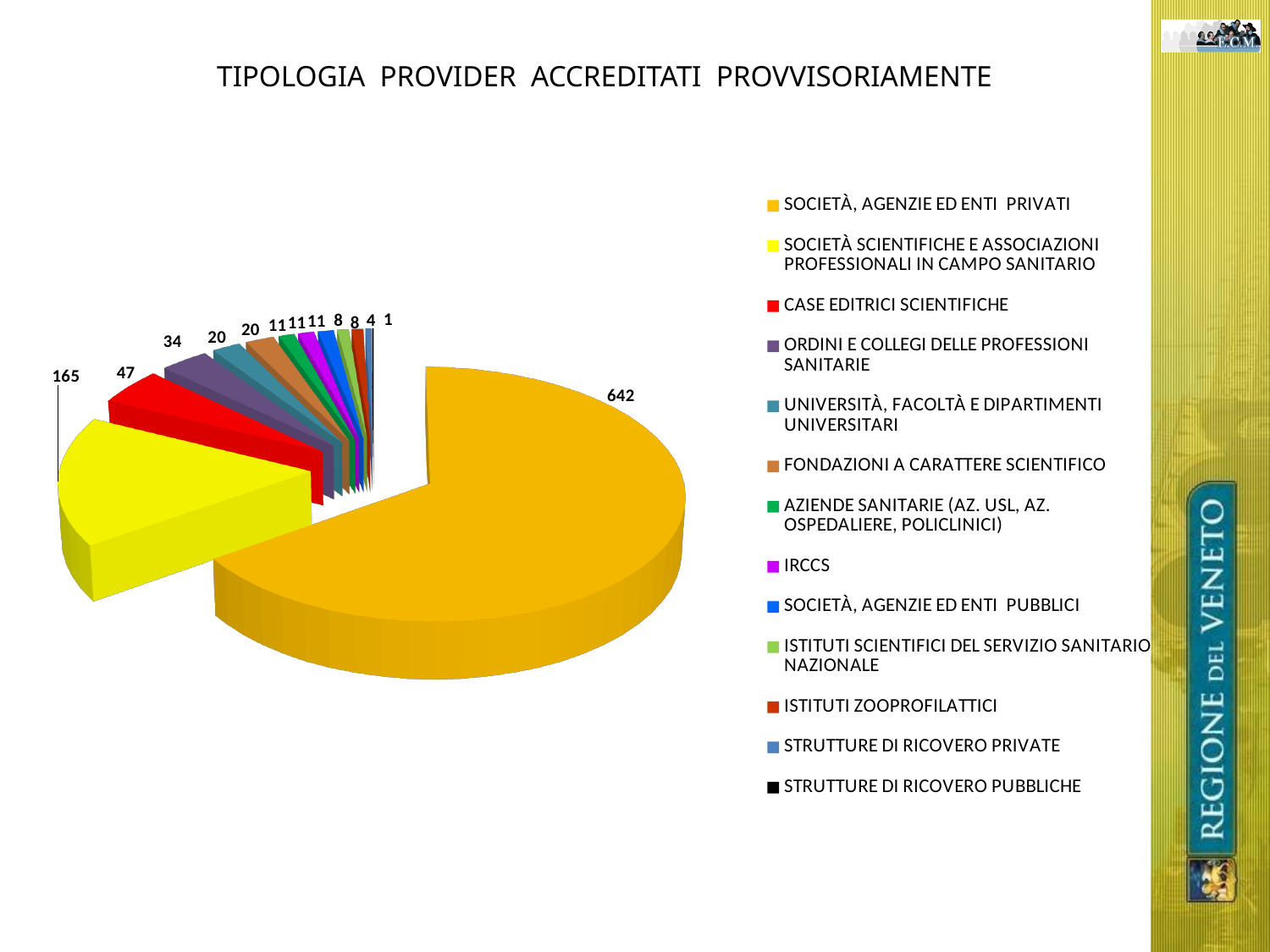
Which category has the largest slice of the pie? SOCIETÀ, AGENZIE ED ENTI PRIVATI What is the value for ORDINI E COLLEGI DELLE PROFESSIONI SANITARIE? 34 What is the value for SOCIETÀ SCIENTIFICHE E ASSOCIAZIONI PROFESSIONALI IN CAMPO SANITARIO? 165 Which is larger, the value for CASE EDITRICI SCIENTIFICHE or the value for ORDINI E COLLEGI DELLE PROFESSIONI SANITARIE? CASE EDITRICI SCIENTIFICHE What is the value for SOCIETÀ, AGENZIE ED ENTI PRIVATI? 642 What kind of chart is shown on the slide? Pie chart Which category has the smallest slice of the pie? STRUTTURE DI RICOVERO PUBBLICHE What is the difference between the values for SOCIETÀ, AGENZIE ED ENTI PRIVATI and SOCIETÀ SCIENTIFICHE E ASSOCIAZIONI PROFESSIONALI IN CAMPO SANITARIO? 477 What is the total of all the slices in the pie? 982 What is the value for CASE EDITRICI SCIENTIFICHE? 47 What is the title of the chart? TIPOLOGIA PROVIDER ACCREDITATI PROVVISORIAMENTE How many categories does the legend list? 13